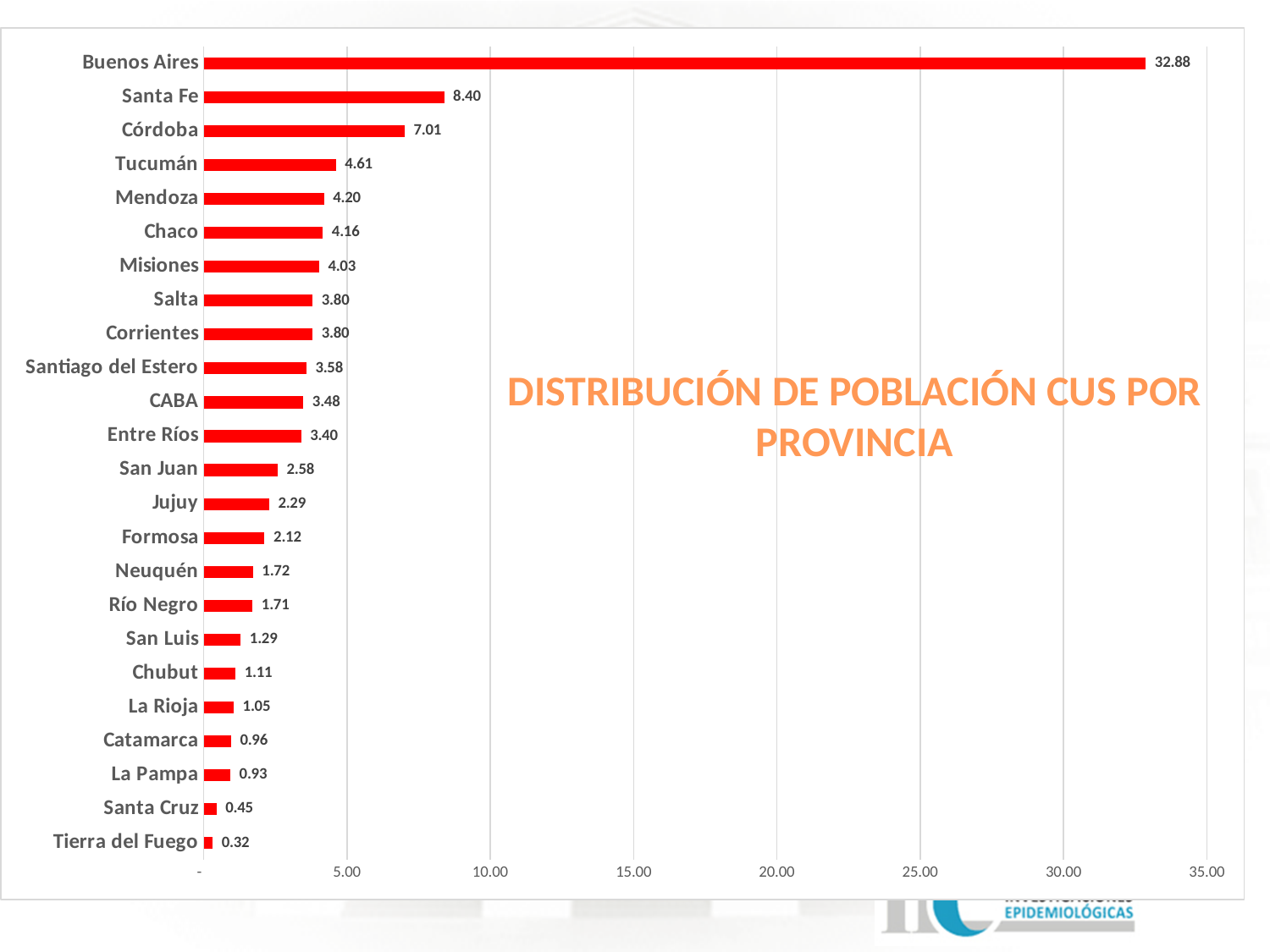
What is the value for Santiago del Estero? 3.58 Which province has the lowest value? Tierra del Fuego What colour are the bars in the chart? red Which has a larger value, Mendoza or Chaco? Mendoza What is the title of the chart? DISTRIBUCIÓN DE POBLACIÓN CUS POR PROVINCIA What is the value for Buenos Aires? 32.88 What is the difference between the values for Santa Fe and Córdoba? 1.39 Which province has the highest value? Buenos Aires What kind of chart is shown on the slide? bar chart Is the value for Santa Fe greater or less than 10.00? less How many provinces are shown in the chart? 24 What is the value for Tierra del Fuego? 0.32